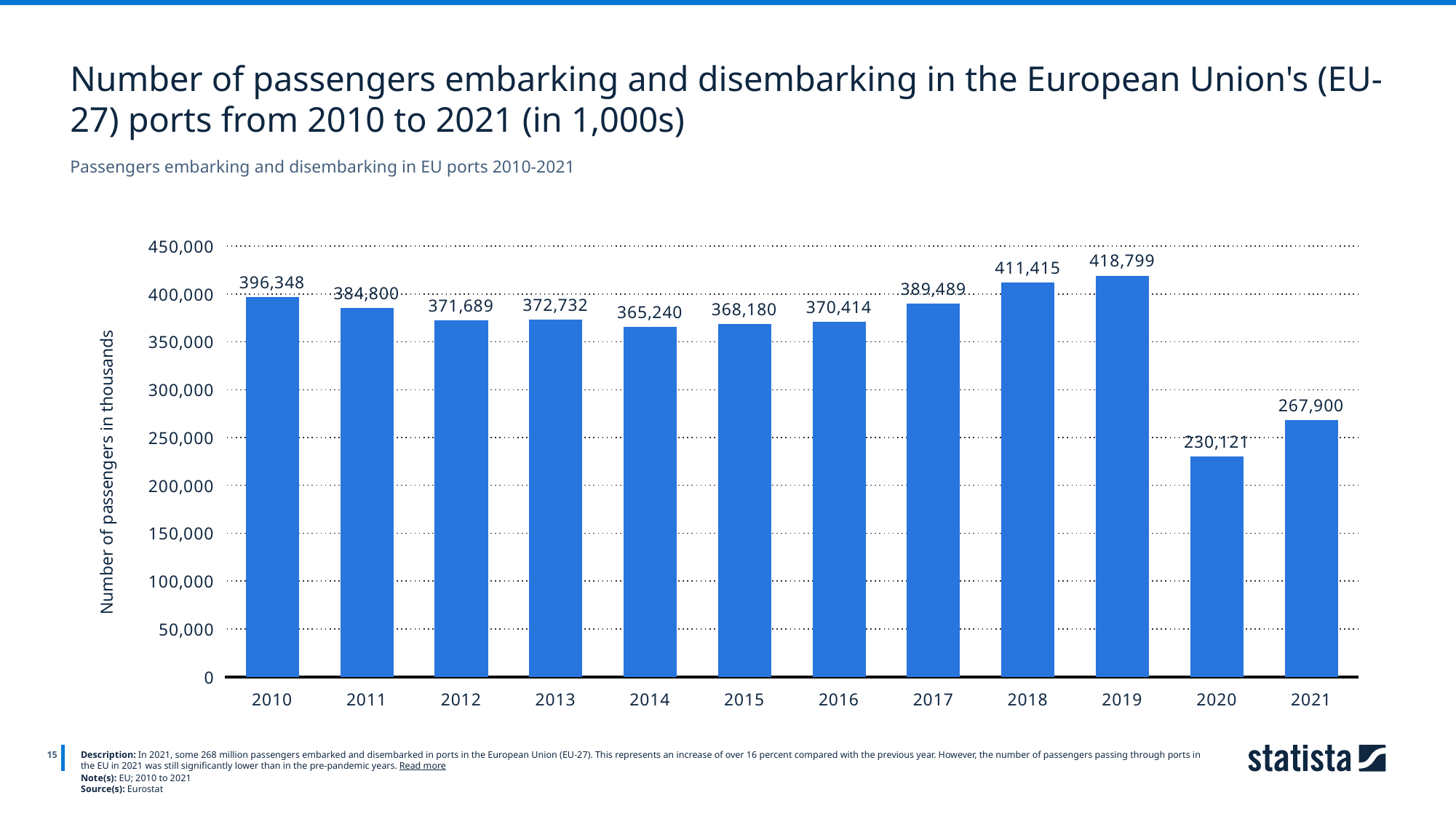
What kind of chart is shown on the slide? Bar chart What is the value shown for 2020? 230,121 What is the difference between the values for 2021 and 2020? 37,779 What is the value shown for 2014? 365,240 Which year has the lowest number of passengers? 2020 What is the number of passengers embarking and disembarking in EU ports in 2019? 418,799 How many years are shown on the x axis? 12 Which year has a larger value, 2010 or 2017? 2010 Is the value for 2021 greater or less than 250,000? greater What is the label of the y axis? Number of passengers in thousands What is the difference between the values for 2019 and 2018? 7,384 Which year has the highest number of passengers? 2019